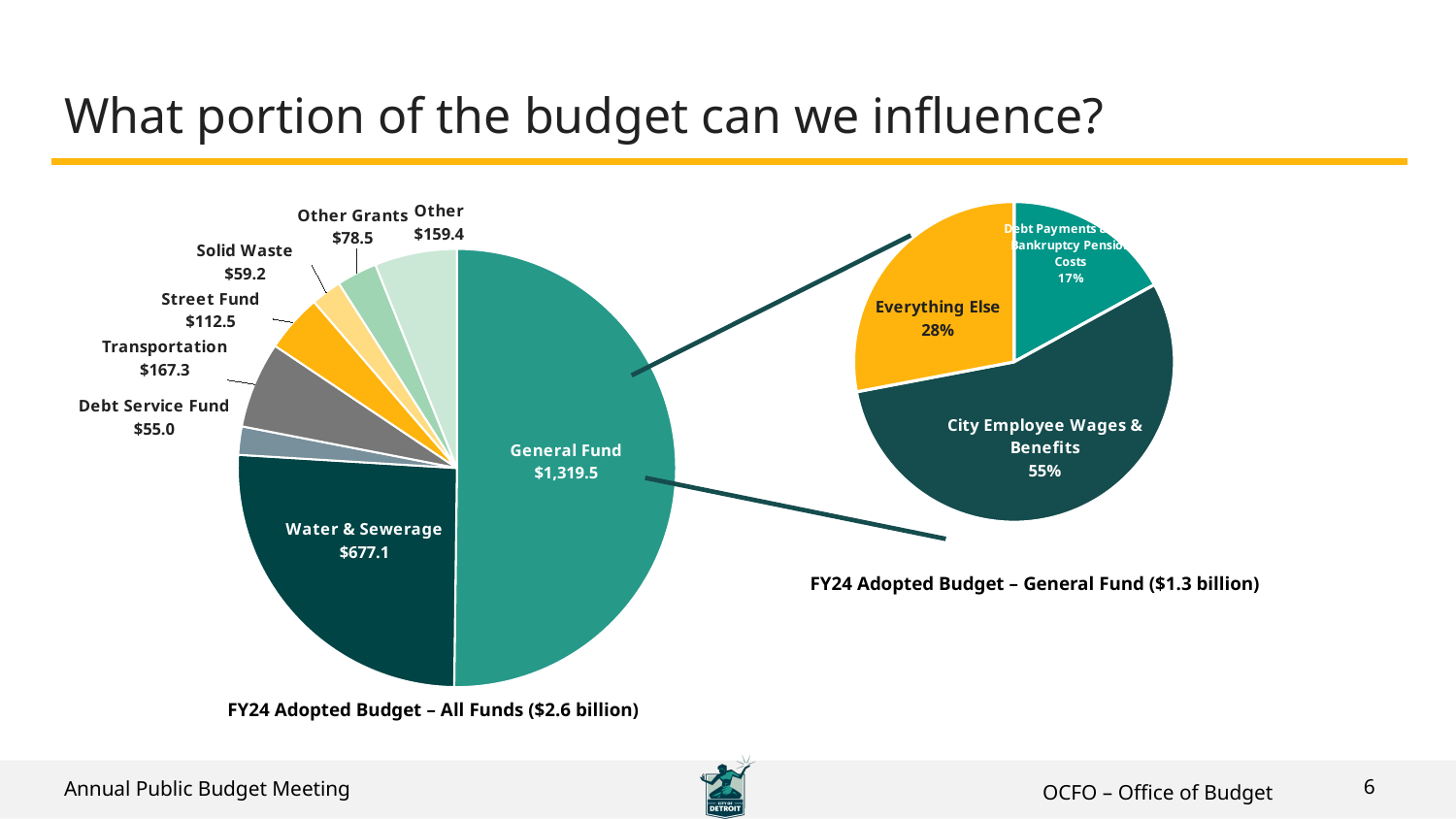
In the FY24 Adopted Budget – All Funds chart, which slice is the smallest? Debt Service Fund In the FY24 Adopted Budget – General Fund chart, which slice is the smallest? Debt Payments & Pre-Bankruptcy Pension Costs In the FY24 Adopted Budget – General Fund chart, what share does City Employee Wages & Benefits have? 55% In the FY24 Adopted Budget – All Funds chart, which slice is the largest? General Fund In the FY24 Adopted Budget – General Fund chart, what share does Everything Else have? 28% How many slices does the FY24 Adopted Budget – All Funds chart have? 8 In the FY24 Adopted Budget – All Funds chart, what is the value for Transportation? $167.3 In the FY24 Adopted Budget – All Funds chart, what is the value for Street Fund? $112.5 In the FY24 Adopted Budget – All Funds chart, what is the difference between General Fund and Water & Sewerage? $642.4 In the FY24 Adopted Budget – All Funds chart, which is larger, Other Grants or Solid Waste? Other Grants In the FY24 Adopted Budget – All Funds chart, what is the value for Water & Sewerage? $677.1 What kind of chart is the FY24 Adopted Budget – General Fund chart? Pie chart